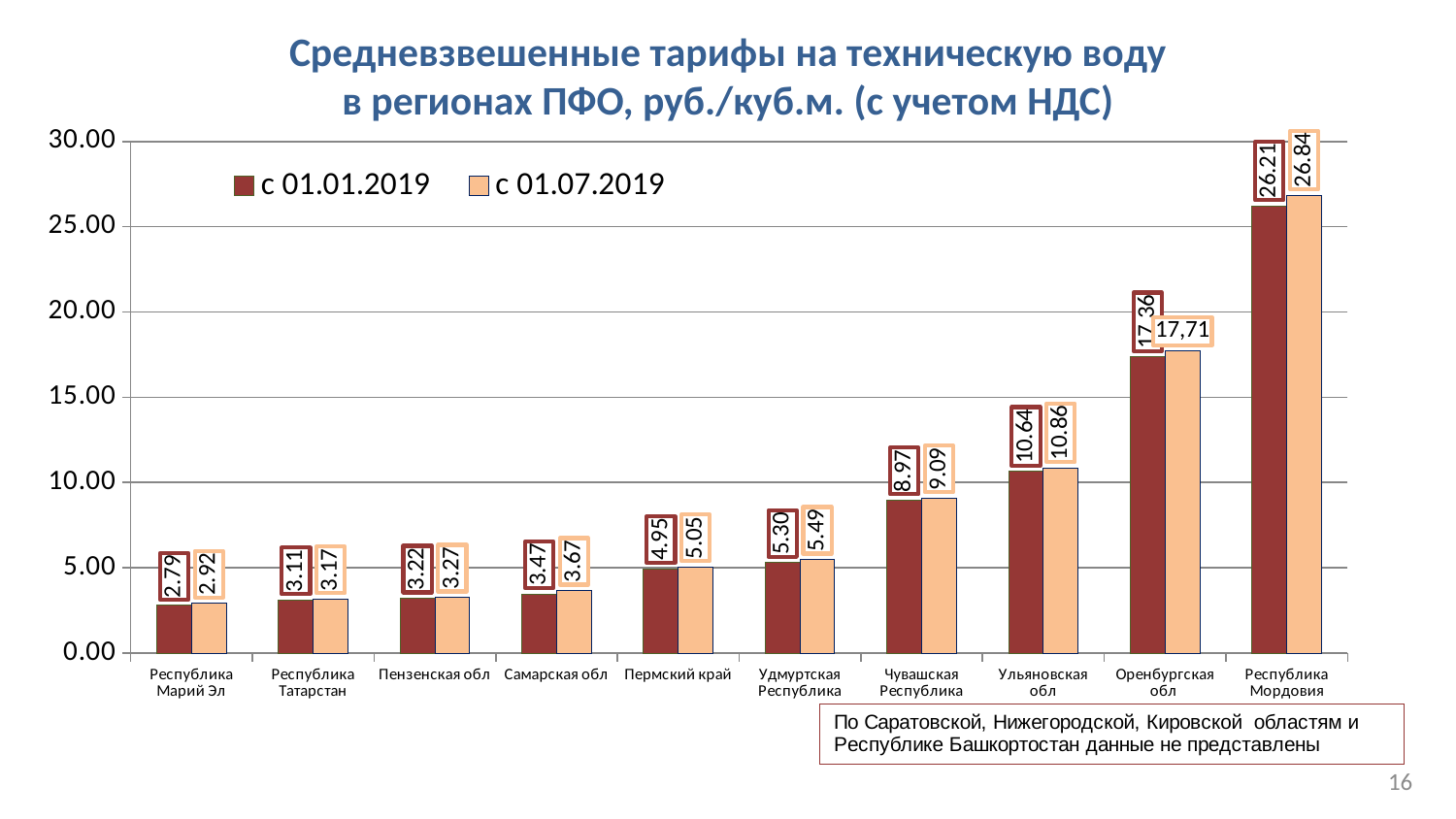
What type of chart is shown on the slide? bar chart How many regions are shown on the x axis? 10 What is the difference between the с 01.07.2019 and с 01.01.2019 values for Республика Мордовия? 0.63 Which is larger: the с 01.01.2019 value for Ульяновская обл or the с 01.07.2019 value for Чувашская Республика? Ульяновская обл (с 01.01.2019) Do the values generally rise or fall moving from left to right along the x axis? rise What is the title of the chart? Средневзвешенные тарифы на техническую воду в регионах ПФО, руб./куб.м. (с учетом НДС) What is the value for Самарская обл in the series с 01.07.2019? 3.67 What is the value for Оренбургская обл in the series с 01.07.2019? 17,71 Which region has the lowest value in the series с 01.01.2019? Республика Марий Эл What is the value for Республика Марий Эл in the series с 01.01.2019? 2.79 How many series does the legend list? 2 Which region has the highest value in the series с 01.07.2019? Республика Мордовия